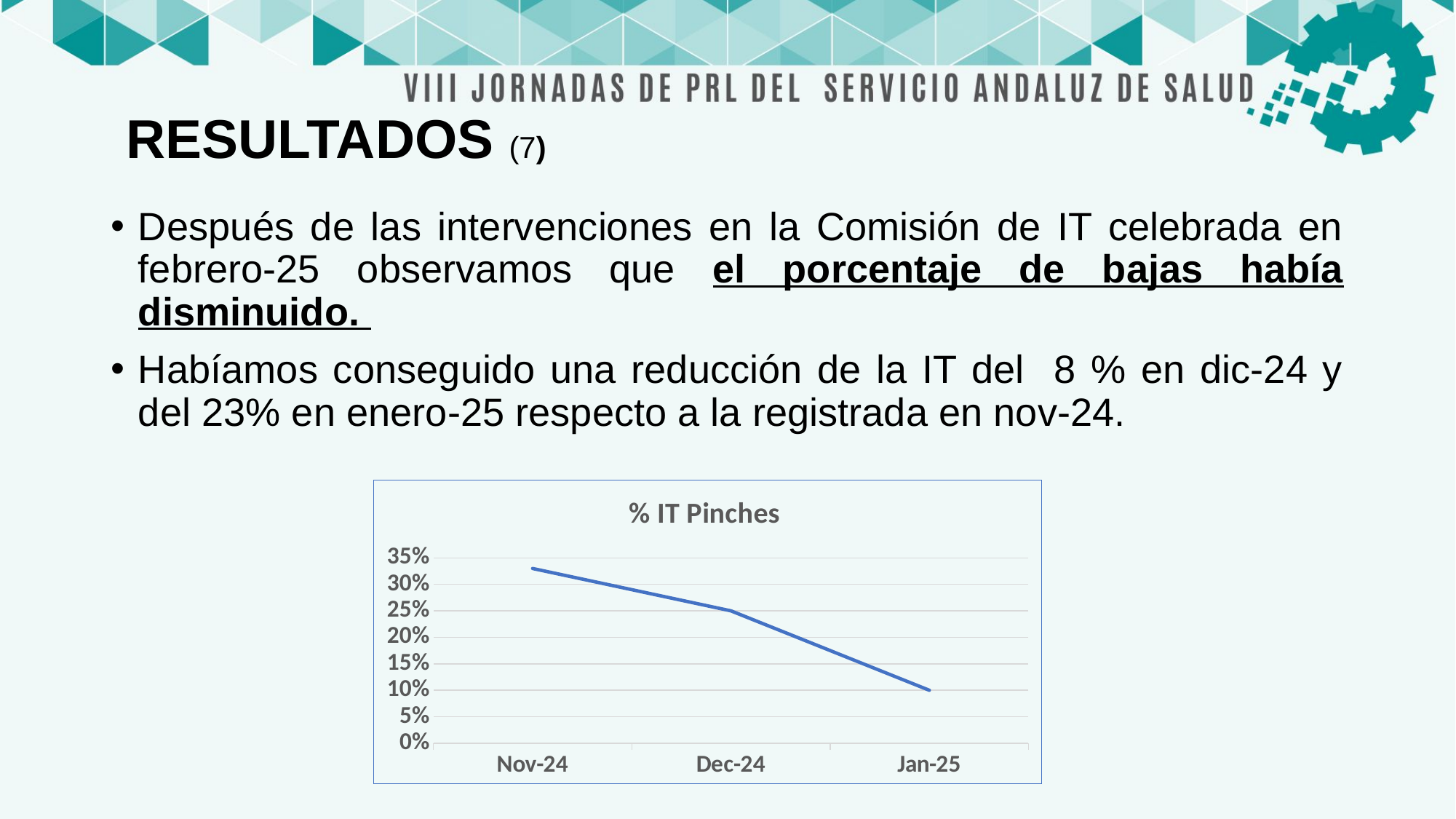
Do the values rise or fall from Nov-24 to Jan-25? fall Which month has the lowest value in the chart? Jan-25 Is the value for Dec-24 greater or less than 20%? greater Is the value for Nov-24 greater or less than 30%? greater How many data points are plotted on the chart? 3 Which is larger, the value for Dec-24 or the value for Jan-25? Dec-24 What is the value for Jan-25? 10% What is the value for Dec-24? 25% What kind of chart is shown on the slide? line chart Is the value for Jan-25 greater or less than 15%? less Which month has the highest value in the chart? Nov-24 What is the title of the chart? % IT Pinches